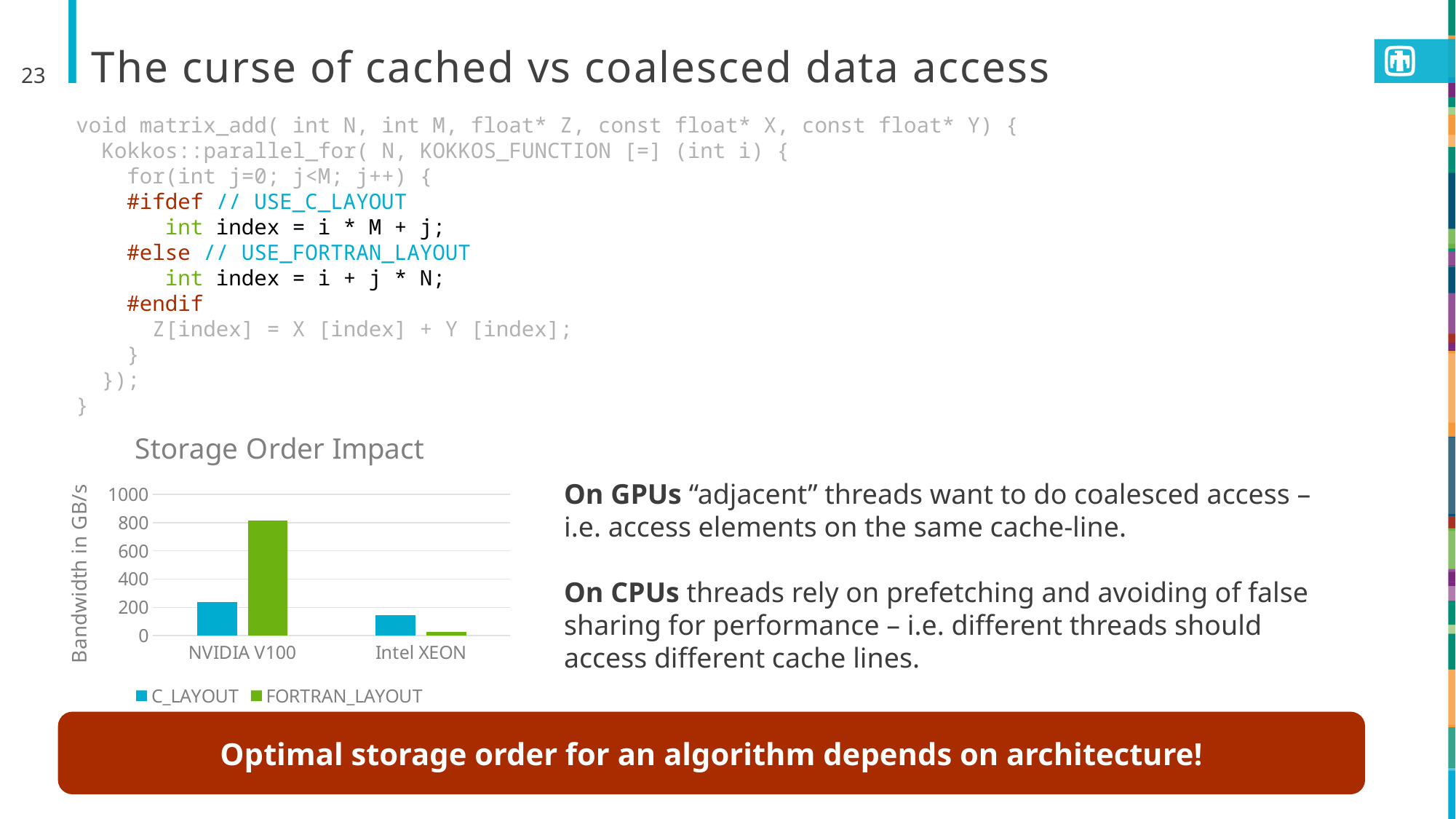
For Intel XEON, which series has the larger bandwidth, C_LAYOUT or FORTRAN_LAYOUT? C_LAYOUT What is the title of the chart on the slide? Storage Order Impact Which bar in the chart is the highest? FORTRAN_LAYOUT on NVIDIA V100 How many series does the chart's legend list? 2 Is the C_LAYOUT value for NVIDIA V100 greater or less than 400? less Which bar in the chart is the lowest? FORTRAN_LAYOUT on Intel XEON Is the C_LAYOUT value for Intel XEON greater or less than 200? less Is the FORTRAN_LAYOUT value for NVIDIA V100 greater or less than 600? greater What type of chart is shown on the slide? bar chart How many categories are shown on the x axis of the chart? 2 For NVIDIA V100, which series has the larger bandwidth, C_LAYOUT or FORTRAN_LAYOUT? FORTRAN_LAYOUT What is the label of the y axis of the chart? Bandwidth in GB/s